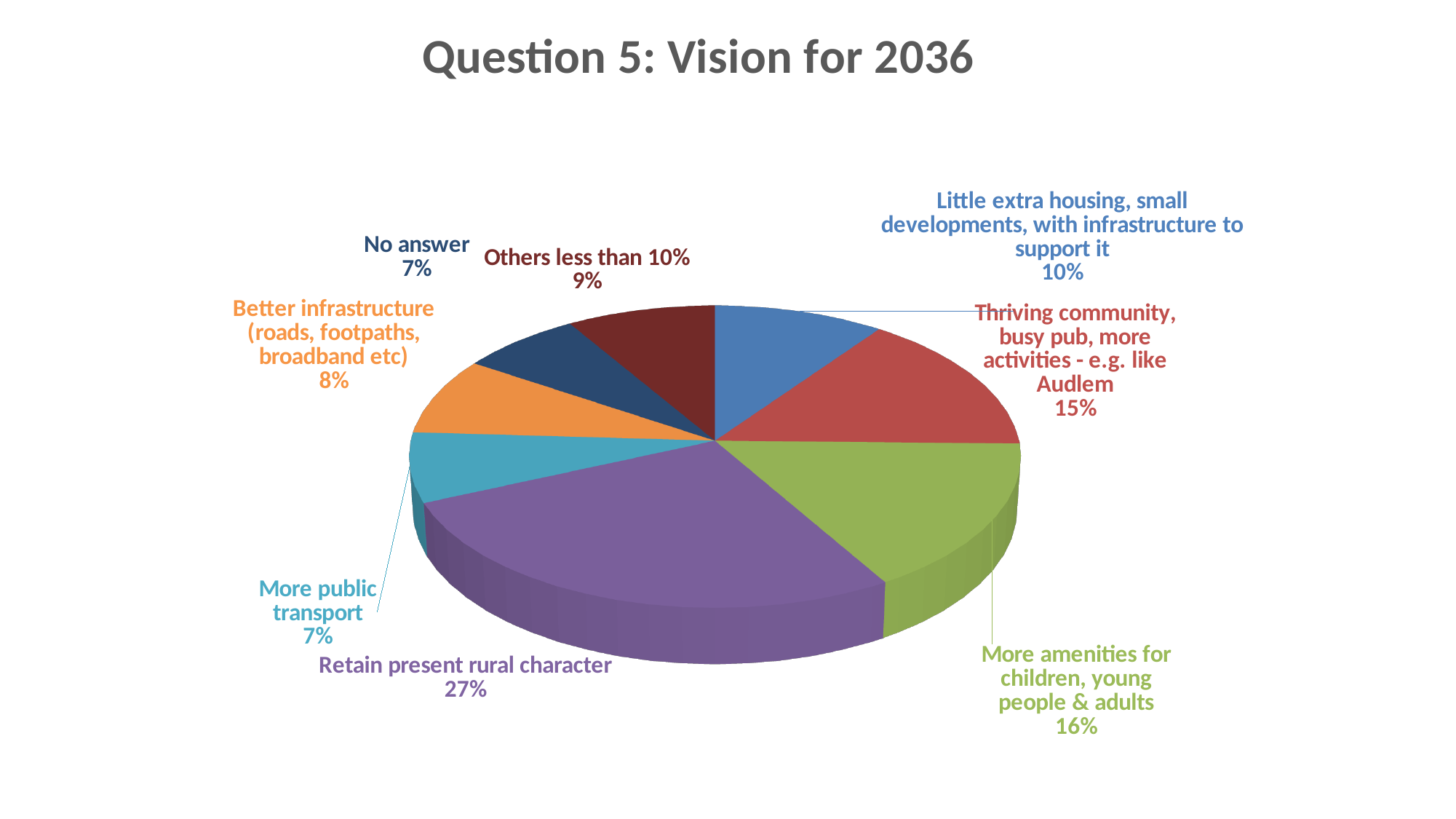
What percentage is shown for 'Retain present rural character'? 27% Which is larger: 'Little extra housing, small developments, with infrastructure to support it' or 'Others less than 10%'? Little extra housing, small developments, with infrastructure to support it What percentage is shown for 'More amenities for children, young people & adults'? 16% What kind of chart is shown on the slide? Pie chart Which category has the largest share of the pie? Retain present rural character What colour is the 'Retain present rural character' slice? Purple What is the title of the chart? Question 5: Vision for 2036 What percentage is shown for 'Thriving community, busy pub, more activities - e.g. like Audlem'? 15% What percentage is shown for 'Better infrastructure (roads, footpaths, broadband etc)'? 8% What is the difference in percentage points between 'Retain present rural character' and 'More amenities for children, young people & adults'? 11 How many slices does the pie chart have? 8 What percentage is shown for 'No answer'? 7%